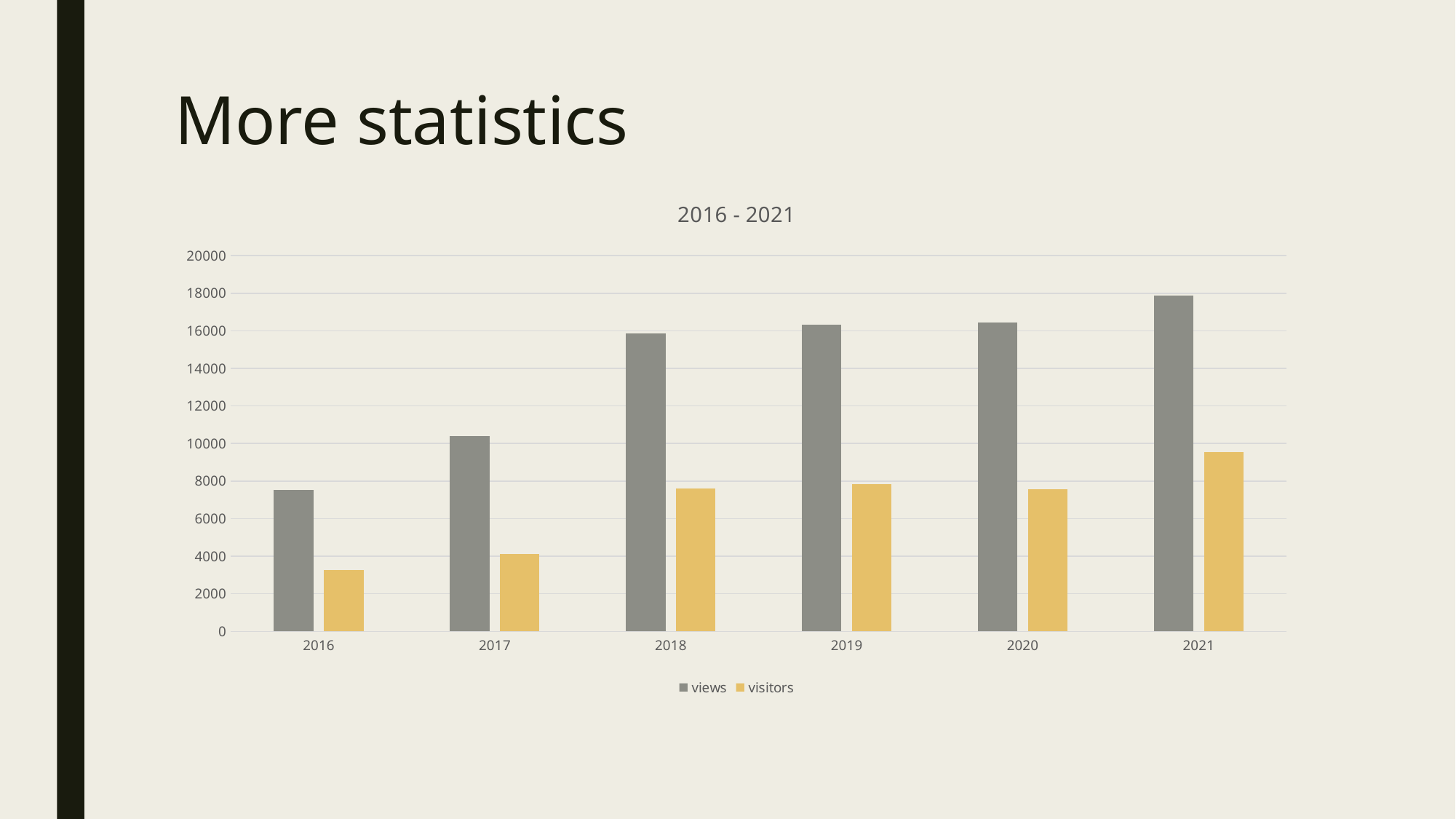
Which year has the lowest value for visitors? 2016 Which year has the lowest value for views? 2016 What kind of chart is shown on the slide? bar chart How many series does the legend list? 2 Which year has the highest value for visitors? 2021 Do the values for views rise or fall from 2016 to 2021? rise What is the title of the chart? 2016 - 2021 Which year has the highest value for views? 2021 Is the value for visitors in 2016 greater or less than 4000? less How many years are shown on the x axis? 6 Is the value for visitors in 2021 greater or less than 8000? greater Which is larger, views in 2017 or views in 2018? views in 2018